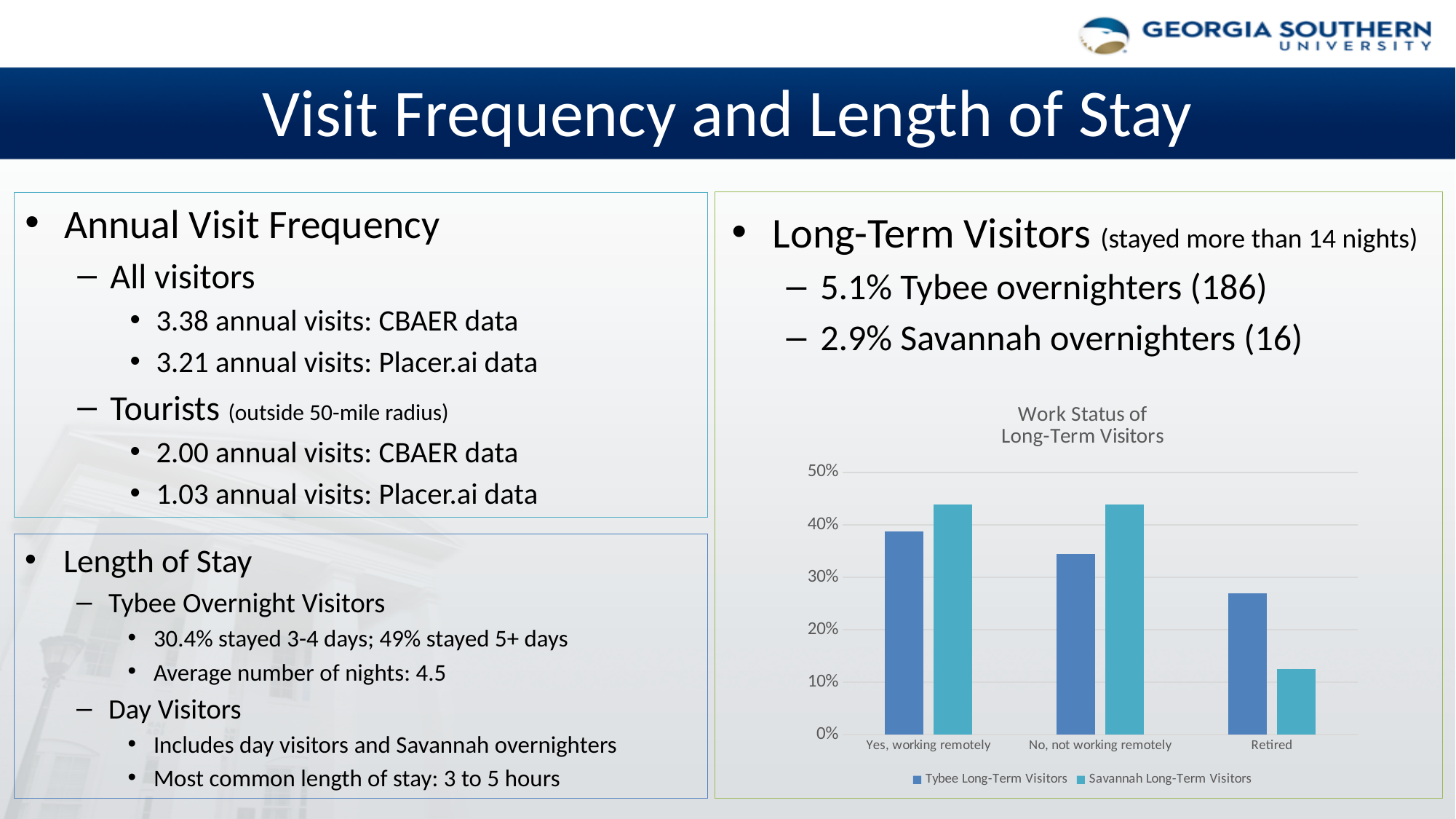
In the "Work Status of Long-Term Visitors" chart, for the "Retired" category, which series has the larger value: Tybee Long-Term Visitors or Savannah Long-Term Visitors? Tybee Long-Term Visitors In the "Work Status of Long-Term Visitors" chart, for "Yes, working remotely", which series has the larger value: Tybee Long-Term Visitors or Savannah Long-Term Visitors? Savannah Long-Term Visitors In the "Work Status of Long-Term Visitors" chart, is the value for Savannah Long-Term Visitors in "Retired" greater or less than 20%? less What kind of chart is the "Work Status of Long-Term Visitors" chart? bar chart In the "Work Status of Long-Term Visitors" chart, which category has the lowest value for Savannah Long-Term Visitors? Retired In the "Work Status of Long-Term Visitors" chart, is the value for Tybee Long-Term Visitors in "Yes, working remotely" greater or less than 30%? greater In the "Work Status of Long-Term Visitors" chart, do the values for Tybee Long-Term Visitors rise or fall from left to right across the categories? fall In the "Work Status of Long-Term Visitors" chart, is the value for Savannah Long-Term Visitors in "No, not working remotely" greater or less than 40%? greater In the "Work Status of Long-Term Visitors" chart, which category has the lowest value for Tybee Long-Term Visitors? Retired How many categories are shown on the x axis of the "Work Status of Long-Term Visitors" chart? 3 How many series does the legend of the "Work Status of Long-Term Visitors" chart list? 2 In the "Work Status of Long-Term Visitors" chart, which category has the highest value for Tybee Long-Term Visitors? Yes, working remotely